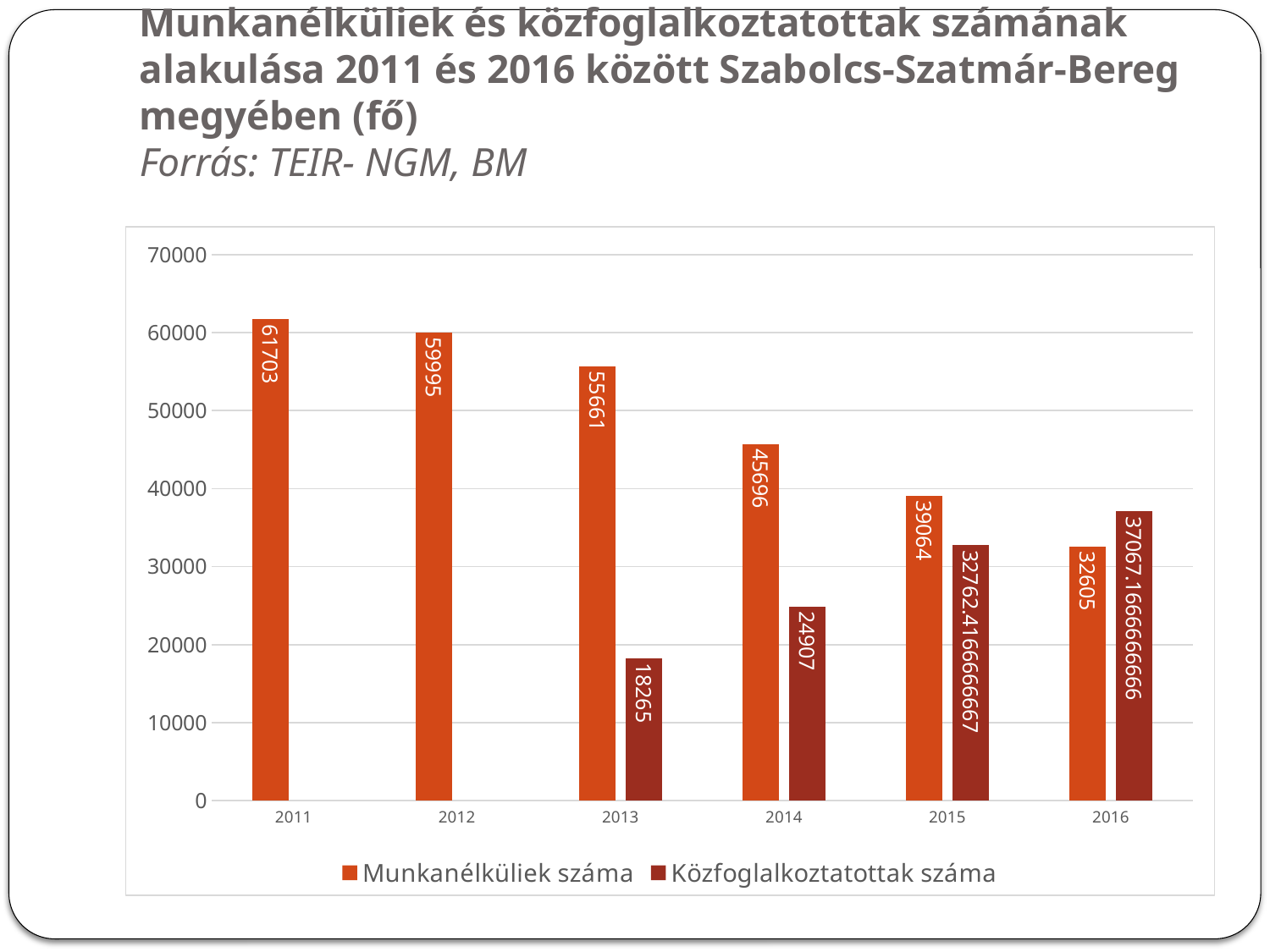
What is the value for Munkanélküliek száma in 2016? 32605 In 2016, which is larger: Munkanélküliek száma or Közfoglalkoztatottak száma? Közfoglalkoztatottak száma In which year is Munkanélküliek száma lowest? 2016 In which year is Munkanélküliek száma highest? 2011 What is the value for Munkanélküliek száma in 2011? 61703 How many series does the legend list? 2 How many years are shown on the x axis? 6 What is the value for Közfoglalkoztatottak száma in 2014? 24907 What is the value for Közfoglalkoztatottak száma in 2013? 18265 Does Munkanélküliek száma rise or fall from 2011 to 2016? fall What is the difference between Munkanélküliek száma in 2011 and in 2012? 1708 Is the value for Közfoglalkoztatottak száma in 2015 greater or less than 30000? greater